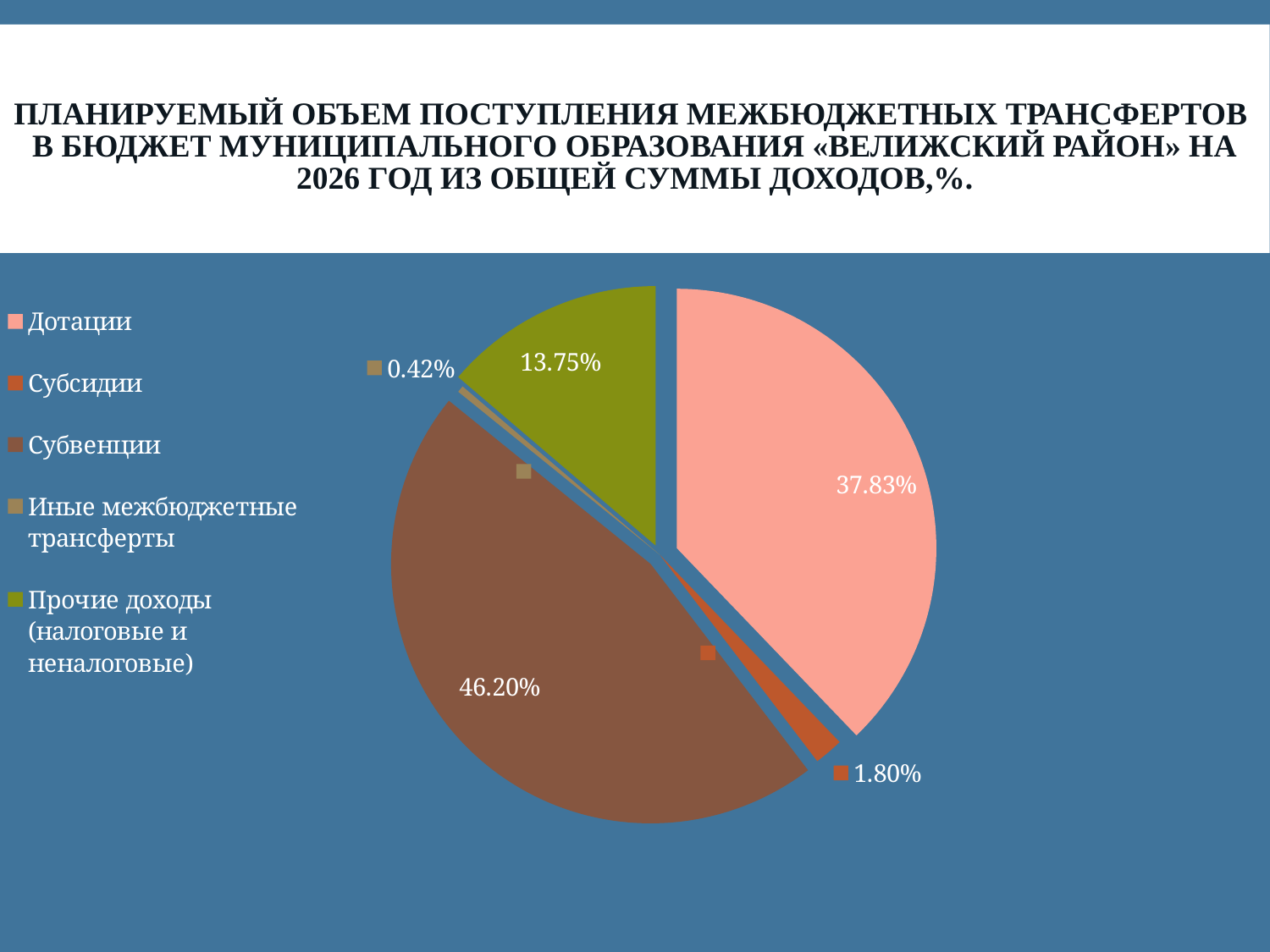
What is the value for Субсидии? 1.80% What is the value for Дотации? 37.83% Which category has the smallest share of the pie? Иные межбюджетные трансферты What kind of chart is shown on the slide? Pie chart What colour is the slice for Прочие доходы (налоговые и неналоговые)? Green What is the difference between the values for Субвенции and Дотации? 8.37% What is the value for Прочие доходы (налоговые и неналоговые)? 13.75% How many categories does the pie chart show? 5 Which category has the largest share of the pie? Субвенции What is the value for Иные межбюджетные трансферты? 0.42% Which is larger, the value for Прочие доходы (налоговые и неналоговые) or the value for Субсидии? Прочие доходы (налоговые и неналоговые) What is the value for Субвенции? 46.20%